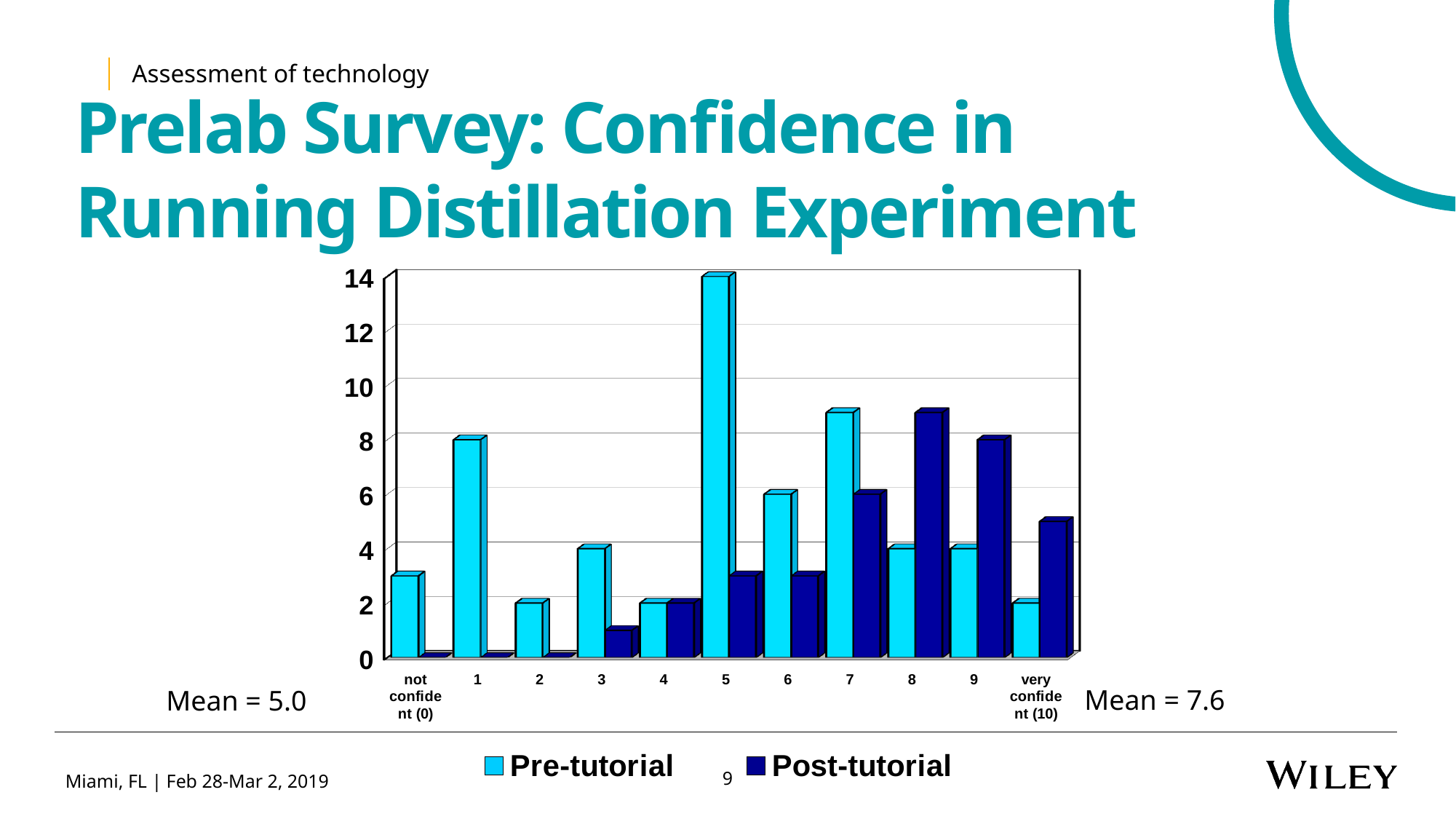
At confidence level 1, which is larger: the Pre-tutorial or the Post-tutorial bar? Pre-tutorial What are the two series named in the legend? Pre-tutorial and Post-tutorial Is the Post-tutorial value at confidence level 9 greater or less than 6? greater What kind of chart is shown on the slide? bar chart Which confidence level has the highest Post-tutorial bar? 8 At confidence level 8, which is larger: the Pre-tutorial or the Post-tutorial bar? Post-tutorial How many series does the legend list? 2 What is the Pre-tutorial value at confidence level 5? 14 How many confidence categories are shown along the x axis? 11 Which confidence level has the highest Pre-tutorial bar? 5 Is the Pre-tutorial value at confidence level 1 greater or less than 6? greater Is the Post-tutorial value at confidence level 3 greater or less than 2? less